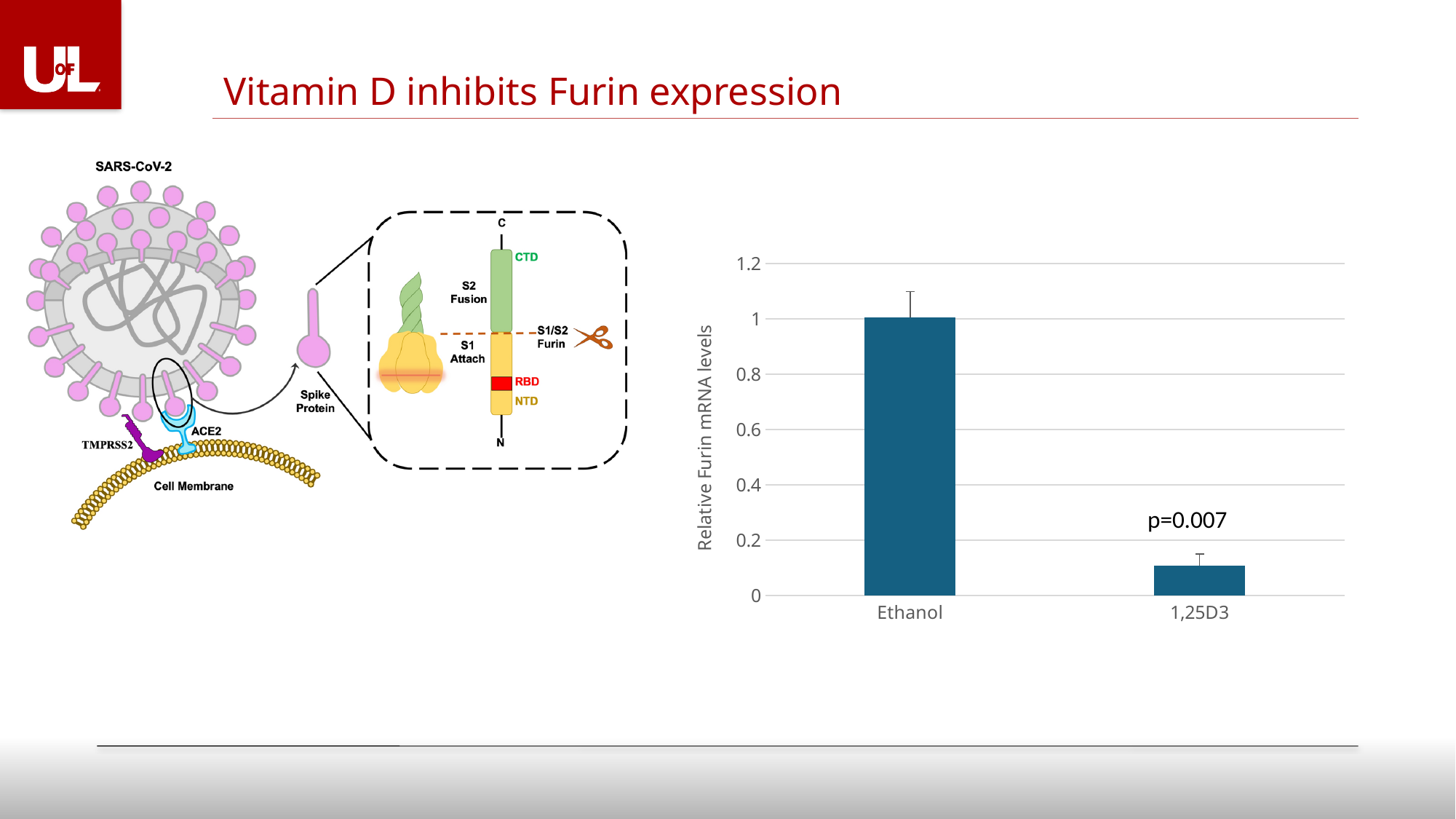
Which is larger, the value for Ethanol or the value for 1,25D3? Ethanol Which category has the highest relative Furin mRNA level? Ethanol Which category has the lowest relative Furin mRNA level? 1,25D3 Is the value for 1,25D3 greater or less than 0.2? less What p-value is printed above the 1,25D3 bar? p=0.007 Do the values rise or fall from Ethanol to 1,25D3 along the x axis? fall What is the label of the y axis on the bar chart? Relative Furin mRNA levels How many categories are plotted on the bar chart? 2 Is the value for Ethanol greater or less than 0.8? greater What kind of chart is shown on the right side of the slide? bar chart